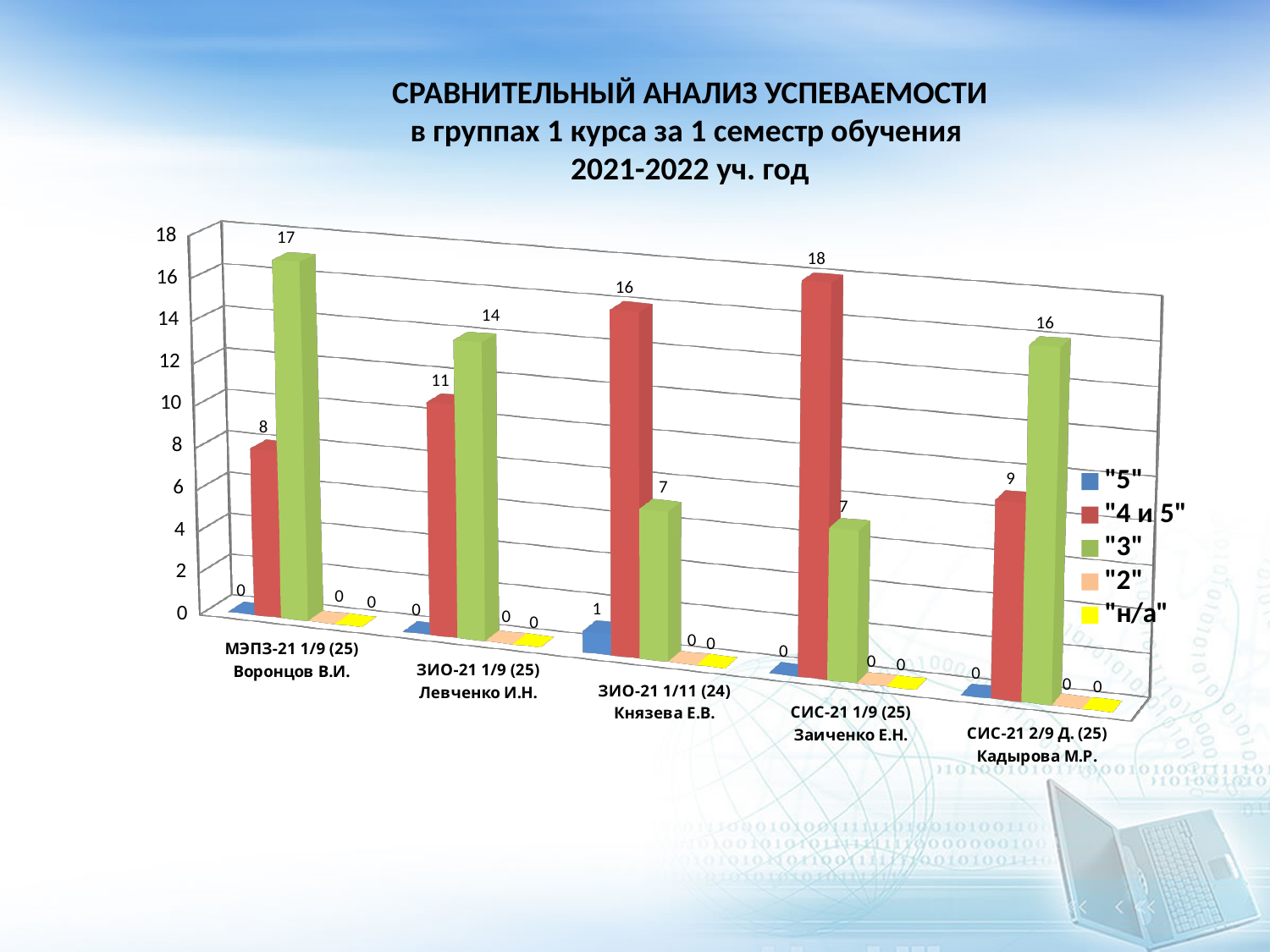
How many series does the legend list? 5 What is the title of the chart on the slide? СРАВНИТЕЛЬНЫЙ АНАЛИЗ УСПЕВАЕМОСТИ в группах 1 курса за 1 семестр обучения 2021-2022 уч. год For ЗИО-21 1/11 (24) Князева Е.В., which is larger: the "4 и 5" value or the "3" value? "4 и 5" Which group has the highest value for "4 и 5"? СИС-21 1/9 (25) Заиченко Е.Н. How many groups (categories) are shown on the x axis? 5 What is the total of the "4 и 5" and "3" values for СИС-21 1/9 (25) Заиченко Е.Н.? 25 Which group has the lowest value for "4 и 5"? МЭПЗ-21 1/9 (25) Воронцов В.И. What is the value of "4 и 5" for ЗИО-21 1/9 (25) Левченко И.Н.? 11 What type of chart is shown on the slide? bar chart What is the value of "3" for МЭПЗ-21 1/9 (25) Воронцов В.И.? 17 What is the value of "5" for ЗИО-21 1/11 (24) Князева Е.В.? 1 What is the difference between the "3" value and the "4 и 5" value for СИС-21 2/9 Д. (25) Кадырова М.Р.? 7